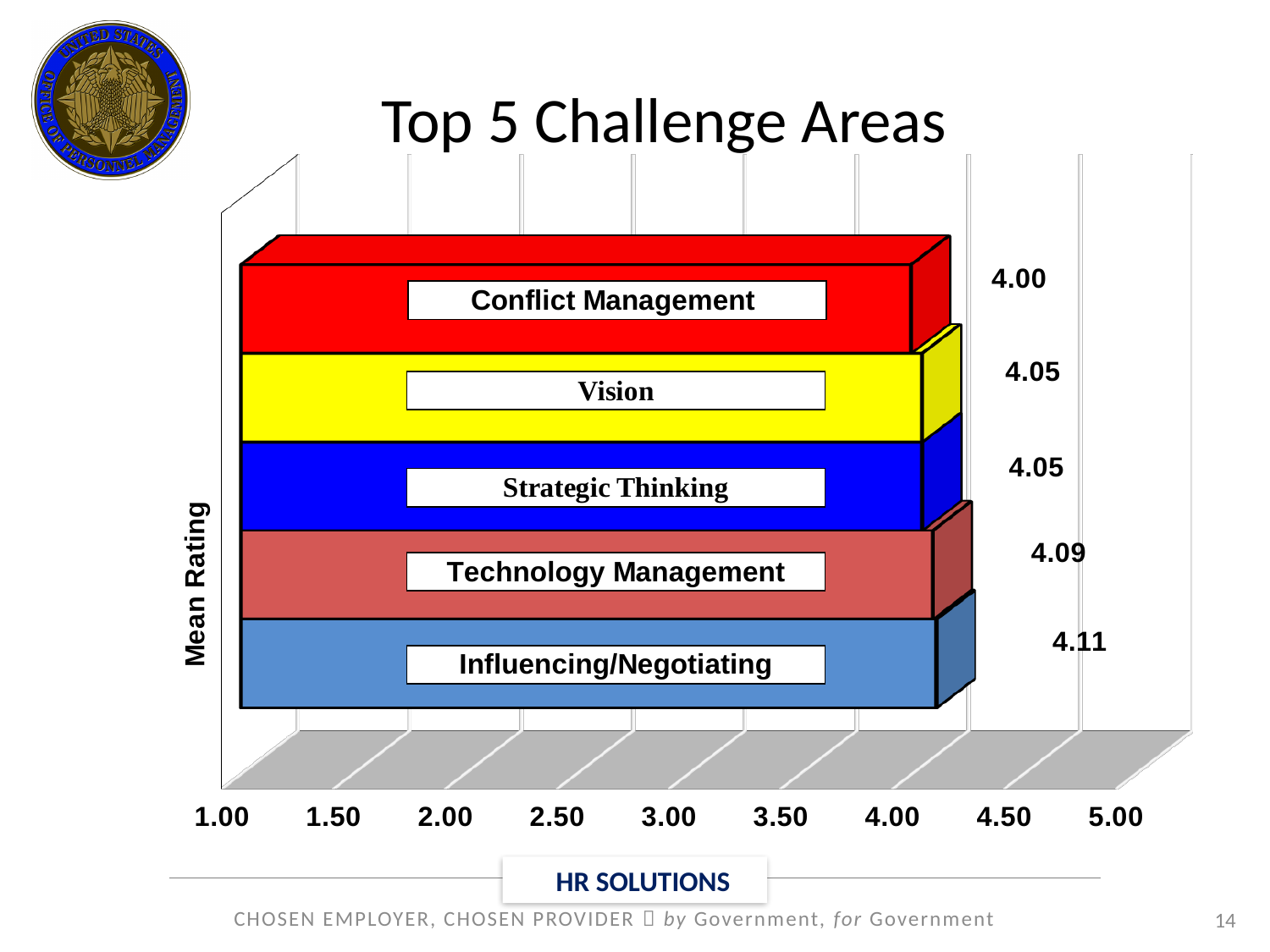
Is the mean rating for Strategic Thinking greater or less than 3.50? greater Which has a higher mean rating, Technology Management or Vision? Technology Management What kind of chart is shown on the slide? bar chart Which challenge area has the highest mean rating? Influencing/Negotiating Which challenge area has the lowest mean rating? Conflict Management How many challenge areas are shown in the chart? 5 What is the title of the chart? Top 5 Challenge Areas What is the mean rating for Influencing/Negotiating? 4.11 What is the difference between the mean ratings for Influencing/Negotiating and Conflict Management? 0.11 What is the mean rating for Conflict Management? 4.00 What is the mean rating for Technology Management? 4.09 What is the mean rating for Vision? 4.05